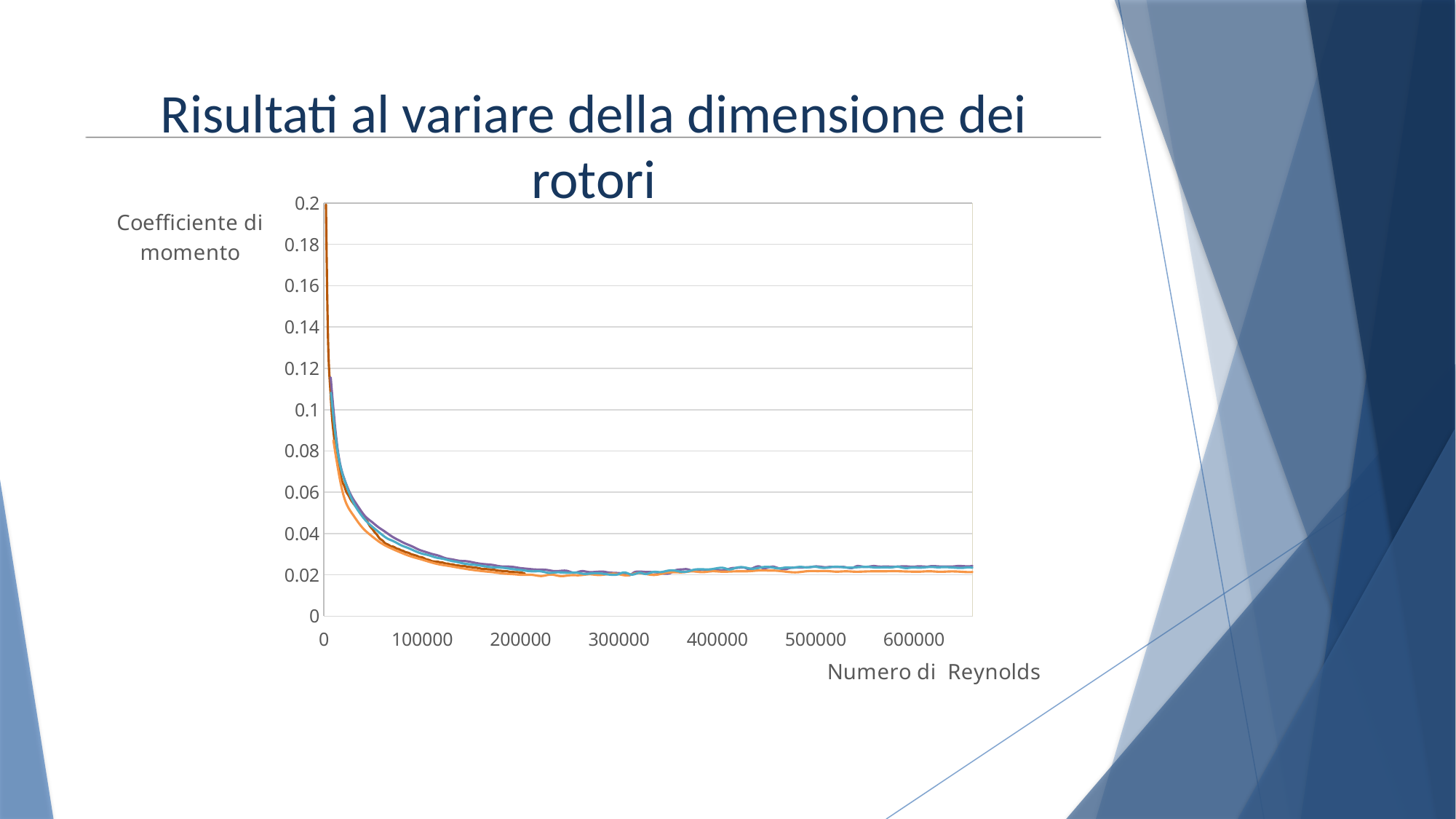
Do the plotted values rise or fall as the Reynolds number increases from 0 to 100000? fall What is the label of the horizontal axis of the chart? Numero di Reynolds Is the value of the coefficiente di momento at a Reynolds number of 600000 greater or less than 0.04? less Is the value of the coefficiente di momento at a Reynolds number of 100000 greater or less than 0.06? less What kind of chart is shown on the slide? line chart Is the value of the coefficiente di momento at a Reynolds number of 300000 greater or less than 0.04? less Which is larger, the coefficiente di momento at a Reynolds number of 50000 or at 600000? at 50000 What is the highest value shown on the vertical axis of the chart? 0.2 What is the title of the chart on the slide? Risultati al variare della dimensione dei rotori